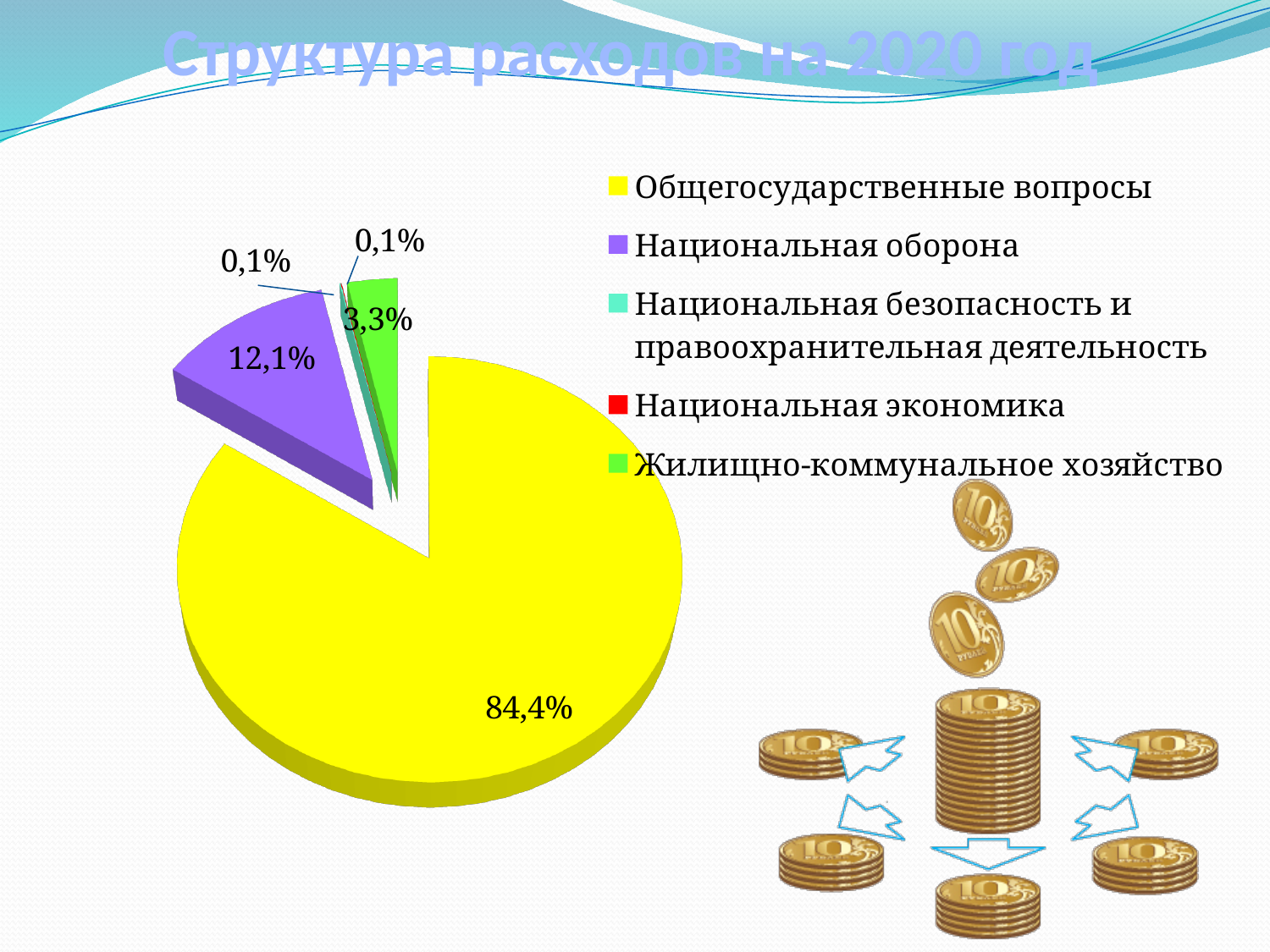
What is the share for Жилищно-коммунальное хозяйство? 3,3% Which category has the largest share of the pie? Общегосударственные вопросы What colour is the slice for Национальная оборона? purple What is the share for Общегосударственные вопросы? 84,4% Which is larger, Национальная оборона or Жилищно-коммунальное хозяйство? Национальная оборона What is the share for Национальная безопасность и правоохранительная деятельность? 0,1% What is the title of the chart? Структура расходов на 2020 год What is the share for Национальная оборона? 12,1% What is the share for Национальная экономика? 0,1% What is the difference between the shares of Общегосударственные вопросы and Национальная оборона? 72,3% How many categories does the legend list? 5 What kind of chart is shown on the slide? pie chart